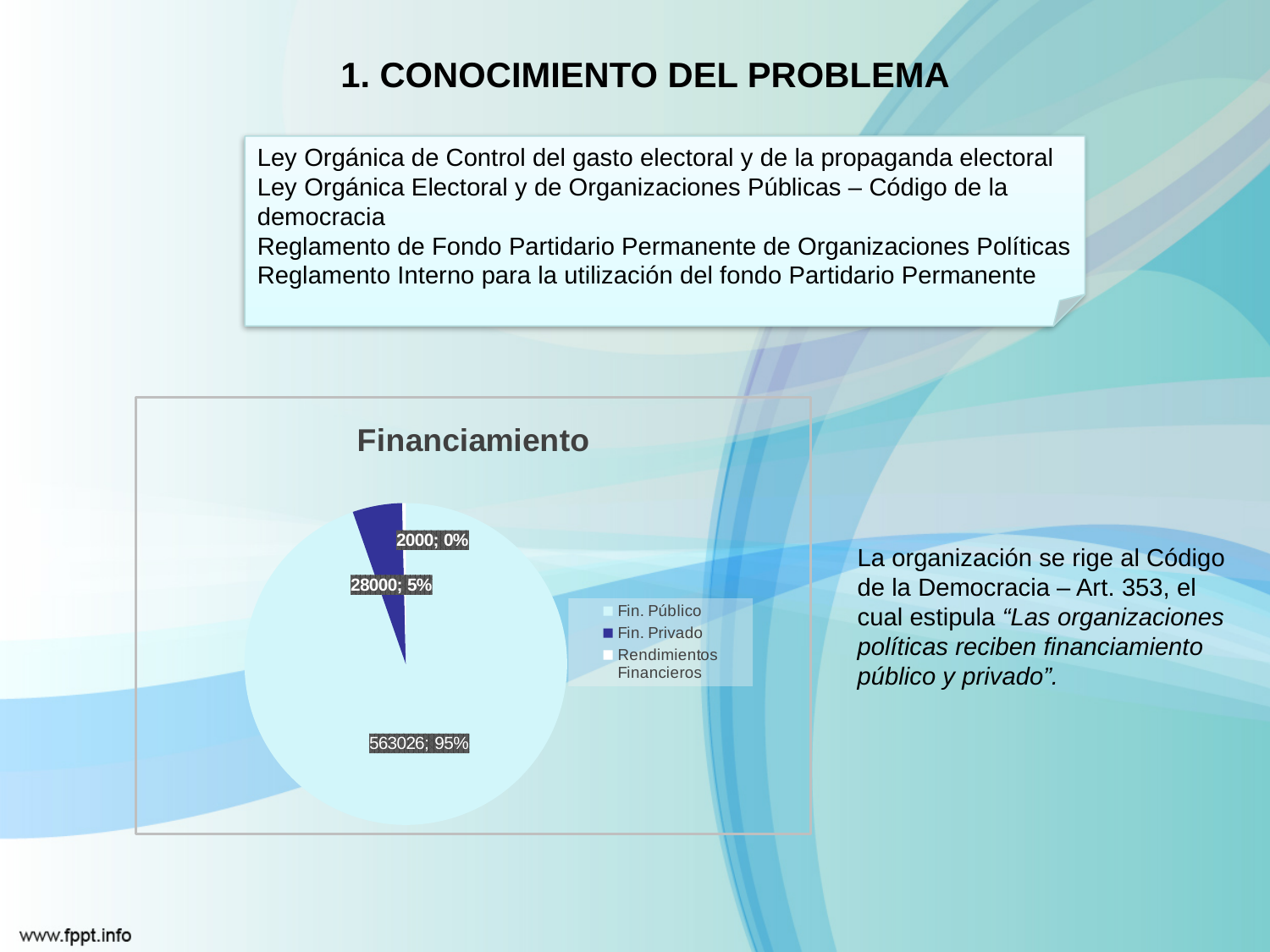
What is the title of the chart on the slide? Financiamiento What kind of chart is shown under the title "Financiamiento"? pie chart What value is shown for Fin. Público in the Financiamiento chart? 563026 How many entries does the legend of the Financiamiento chart list? 3 What share of the Financiamiento pie does Fin. Público represent? 95% What share of the Financiamiento pie does Fin. Privado represent? 5% Which category has the smallest slice in the Financiamiento chart? Rendimientos Financieros What is the difference between the Fin. Privado and Rendimientos Financieros values in the Financiamiento chart? 26000 Which category has the largest slice in the Financiamiento chart? Fin. Público What value is shown for Rendimientos Financieros in the Financiamiento chart? 2000 How many slices does the Financiamiento pie chart have? 3 What value is shown for Fin. Privado in the Financiamiento chart? 28000